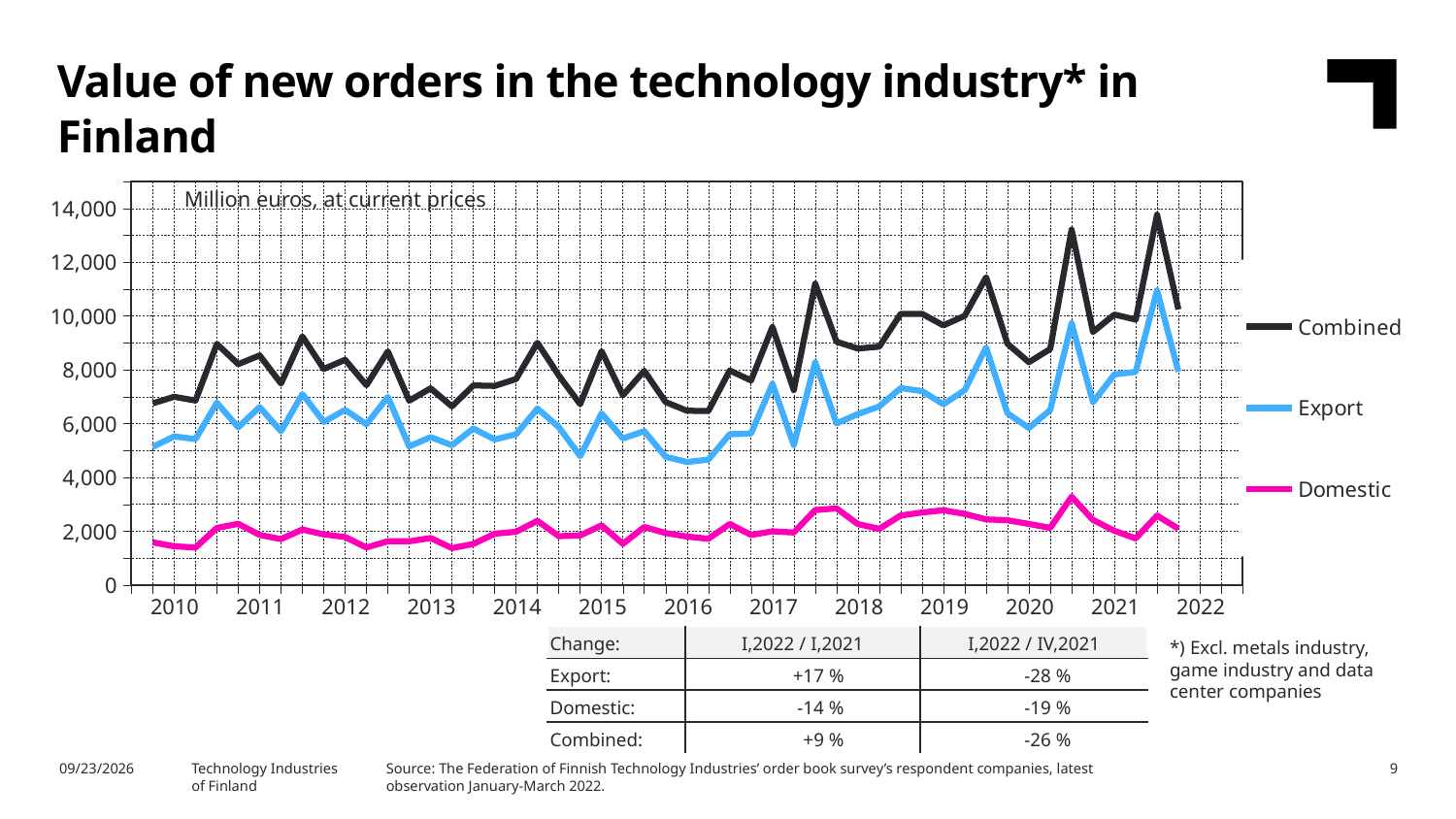
Is the Domestic series ever greater or less than 4,000 over the whole period? less Is the peak value of the Export series in 2021 greater or less than 10,000? greater What kind of chart is shown on the slide? Line chart Which series has the lowest values throughout the chart? Domestic How many series does the legend list? 3 Is the peak value of the Combined series in 2021 greater or less than 12,000? greater Which series has the highest values throughout the chart? Combined Which is larger in 2021, the Export series or the Domestic series? Export What unit is stated for the values in the chart? Million euros, at current prices According to the table, what is the Export change for I,2022 / I,2021? +17 % Which series is plotted in pink? Domestic